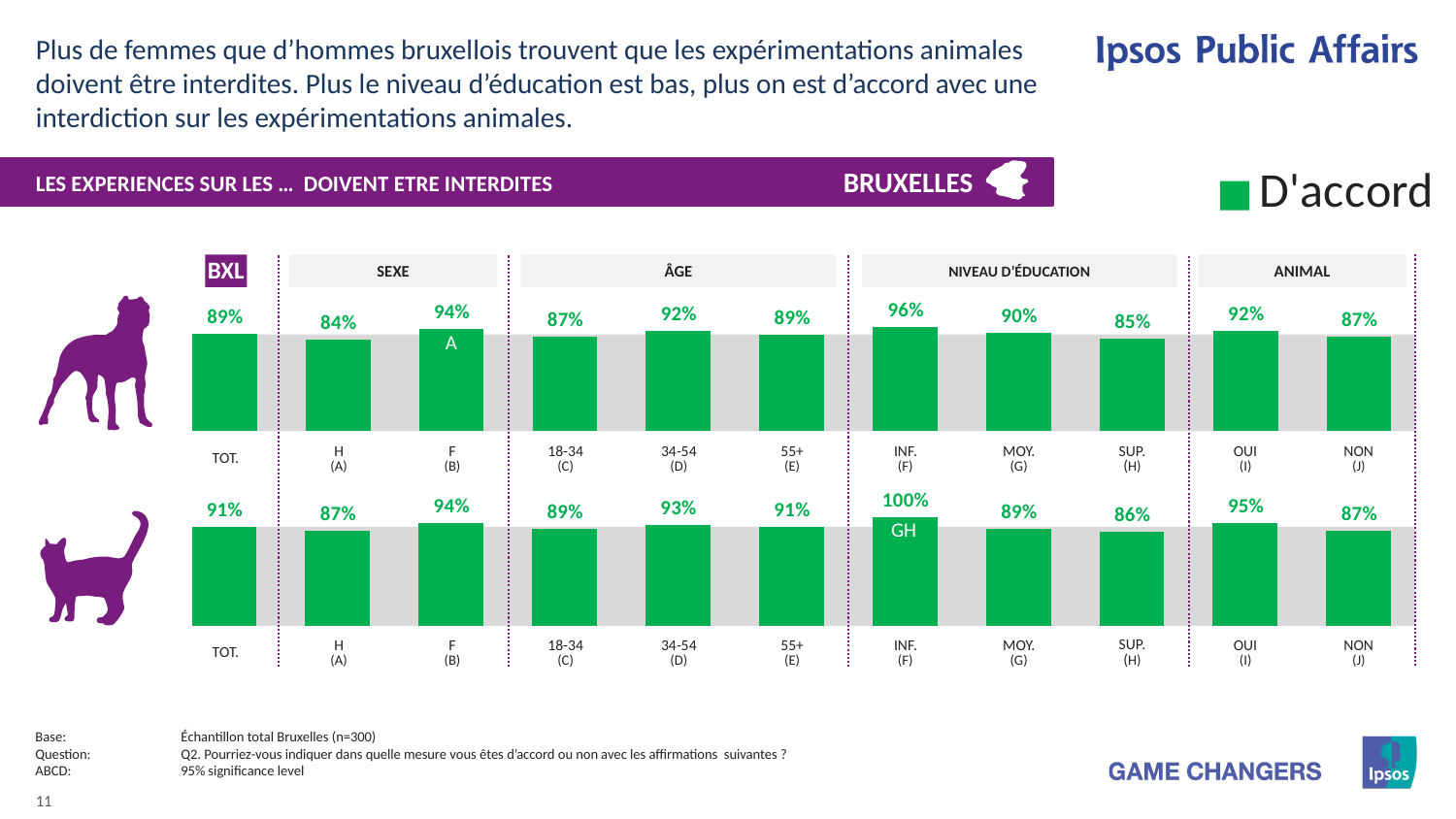
In the bottom row of bars (cat), what is the difference between the values for OUI (I) and NON (J)? 8% In the top row of bars (dog), which is larger: the value for OUI (I) or NON (J)? OUI (I) What kind of chart is used on this slide? Bar chart In the top row of bars (dog), what is the value for TOT.? 89% In the bottom row of bars (cat), what is the value for 34-54 (D) under ÂGE? 93% What is the single legend entry shown at the top right of the slide? D'accord How many bars are in the bottom row of bars (cat), including TOT.? 11 In the top row of bars (dog), what is the difference between the values for F (B) and H (A)? 10% In the top row of bars (dog), what is the value for F (B) under SEXE? 94% In the top row of bars (dog), which education level (INF., MOY., SUP.) has the highest value? INF. In the bottom row of bars (cat), which age group has the lowest value? 18-34 In the bottom row of bars (cat), what is the value for INF. (F) under NIVEAU D'ÉDUCATION? 100%